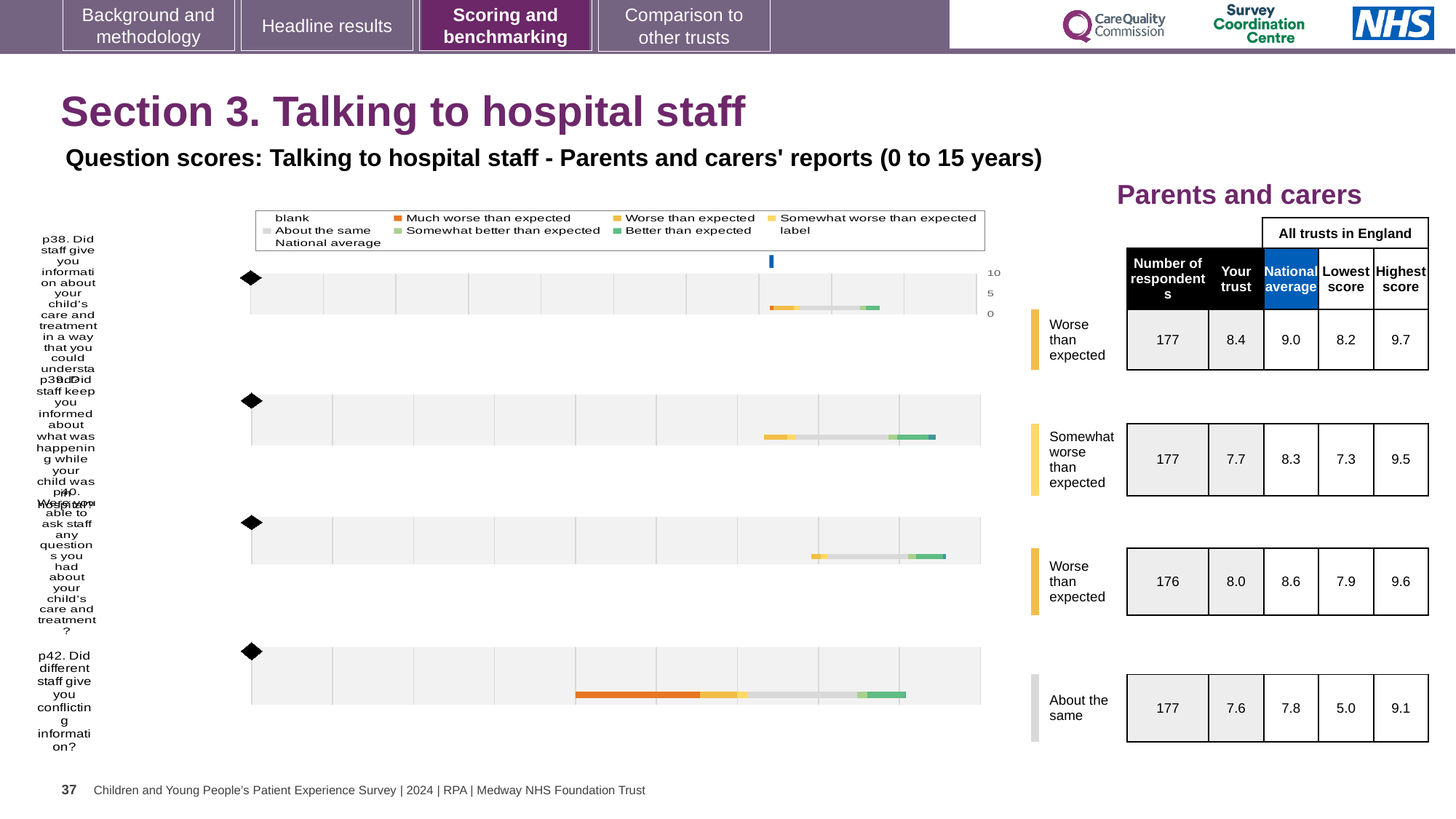
What is the national average score for question p39? 8.3 Which question has the highest 'Your trust' score? p38 What benchmark category is shown for question p42? About the same What is the highest score across all trusts in England for question p42? 9.1 For question p39, which is larger: the 'Your trust' score or the national average? National average For question p38, what is the difference between the national average and the 'Your trust' score? 0.6 Which question has the lowest 'Your trust' score? p42 How many respondents are recorded for question p40? 176 What kind of chart is used to show the question scores on this slide? bar chart For question p42, what is the difference between the highest and lowest scores across all trusts in England? 4.1 What is the 'Your trust' score for question p38? 8.4 How many questions (rows) are plotted in the chart? 4